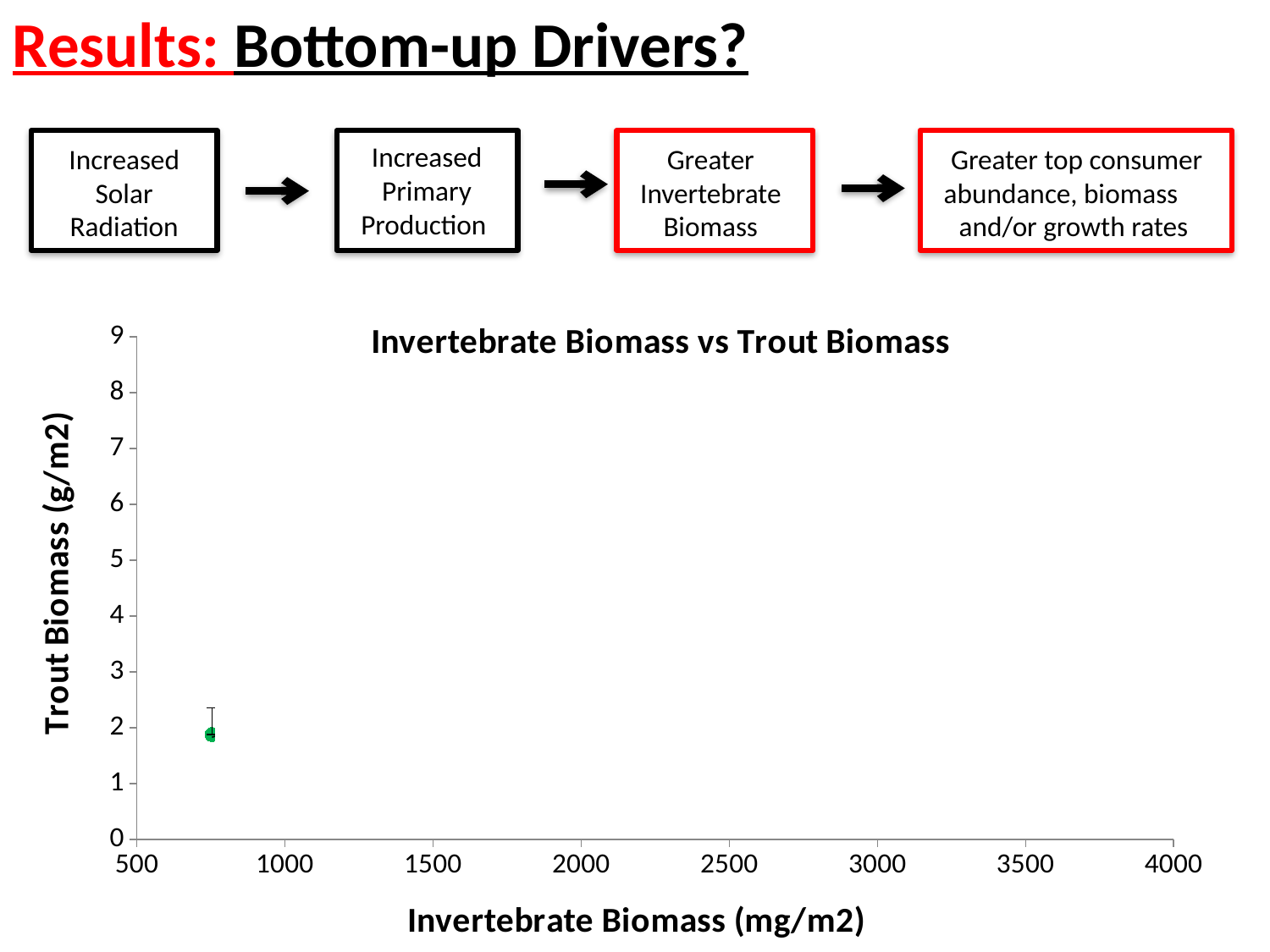
What is the title of the chart? Invertebrate Biomass vs Trout Biomass Is the trout biomass of the plotted point greater or less than 3? less Is the top of the error bar on the plotted point greater or less than 3? less What is the highest value shown on the vertical axis of the chart? 9 What kind of chart is shown on the slide? scatter chart What is the label of the vertical axis of the chart? Trout Biomass (g/m2) What is the lowest value shown on the horizontal axis of the chart? 500 Is the invertebrate biomass of the plotted point greater or less than 1000? less What is the highest value shown on the horizontal axis of the chart? 4000